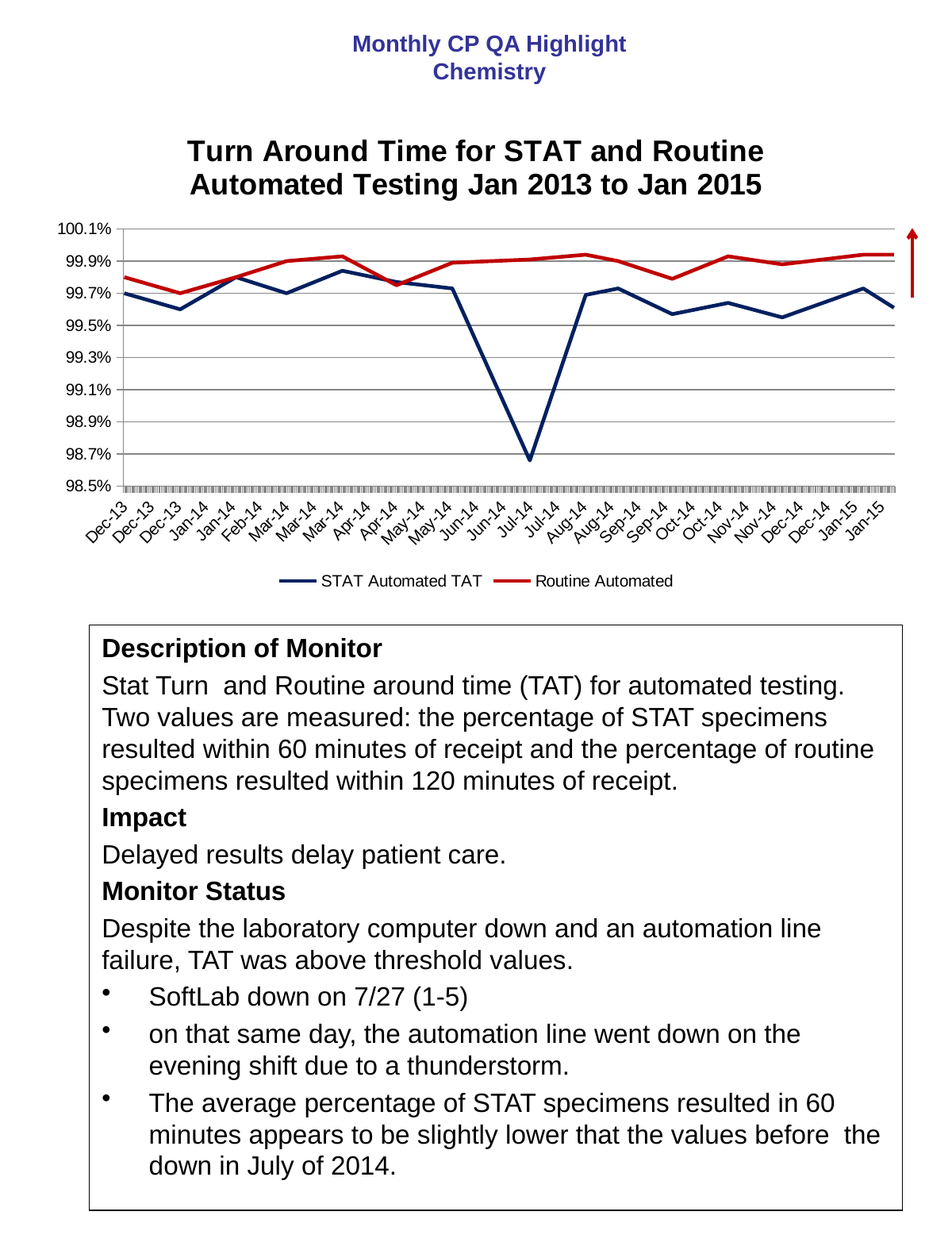
What kind of chart is shown on the slide? Line chart What is the title of the chart? Turn Around Time for STAT and Routine Automated Testing Jan 2013 to Jan 2015 How many series does the legend list? 2 At which month does the STAT Automated TAT series reach its lowest value? Jul-14 Is the STAT Automated TAT value at Jul-14 greater or less than 98.9%? less At Jul-14, which series has the larger value, STAT Automated TAT or Routine Automated? Routine Automated Does the STAT Automated TAT series rise or fall between Jun-14 and Jul-14? Fall Is the Routine Automated value at Jul-14 greater or less than 99.7%? greater Is the STAT Automated TAT value at Jan-15 greater or less than 99.3%? greater Does the STAT Automated TAT series rise or fall between Jul-14 and Aug-14? Rise What are the two series named in the legend? STAT Automated TAT and Routine Automated Which series stays higher across most of the chart, STAT Automated TAT or Routine Automated? Routine Automated